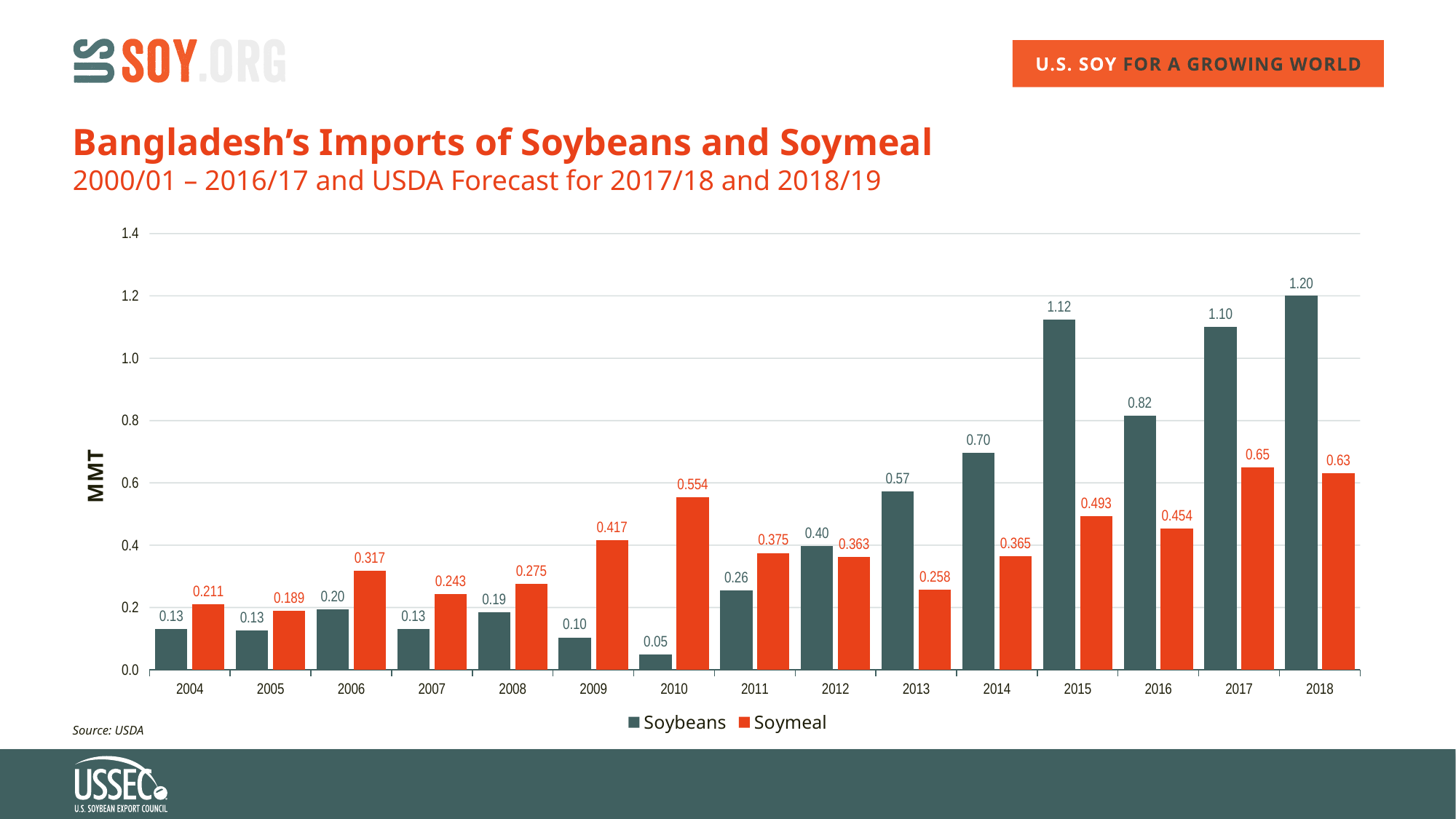
Which year has the lowest Soymeal value? 2005 Which year has the highest Soybeans value? 2018 How many series does the legend list? 2 How many years are shown on the x axis? 15 What is the label on the y axis? MMT Is the Soybeans value for 2016 greater or less than 1.0? less Which year has the lowest Soybeans value? 2010 What is the Soymeal value for 2010? 0.554 What kind of chart is shown on the slide? bar chart What is the Soybeans value for 2015? 1.12 What is the difference between the Soybeans values for 2018 and 2017? 0.10 Which is larger in 2012, the Soybeans value or the Soymeal value? Soybeans